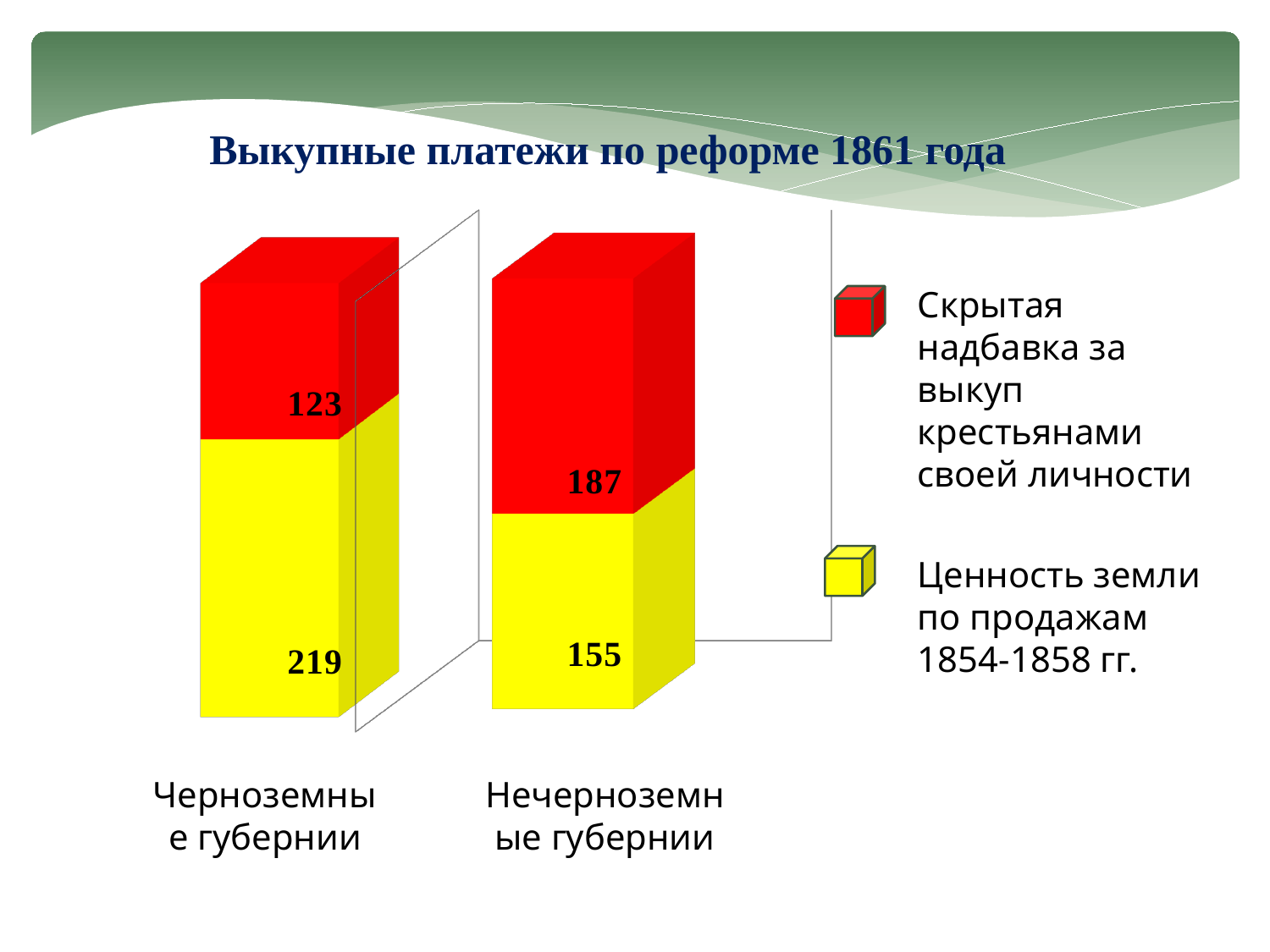
What is the value of 'Ценность земли по продажам 1854-1858 гг.' for Черноземные губернии? 219 What is the value of 'Скрытая надбавка за выкуп крестьянами своей личности' for Черноземные губернии? 123 How many series does the legend list? 2 What is the total of the stacked bar for Черноземные губернии? 342 Which category has the higher value for 'Ценность земли по продажам 1854-1858 гг.'? Черноземные губернии What is the difference between the 'Ценность земли' values for Черноземные губернии and Нечерноземные губернии? 64 Is the 'Скрытая надбавка' value larger for Черноземные губернии or for Нечерноземные губернии? Нечерноземные губернии What is the total of the stacked bar for Нечерноземные губернии? 342 Which category has the lower value for 'Скрытая надбавка за выкуп крестьянами своей личности'? Черноземные губернии What is the title of the chart? Выкупные платежи по реформе 1861 года What is the value of 'Ценность земли по продажам 1854-1858 гг.' for Нечерноземные губернии? 155 What is the value of 'Скрытая надбавка за выкуп крестьянами своей личности' for Нечерноземные губернии? 187